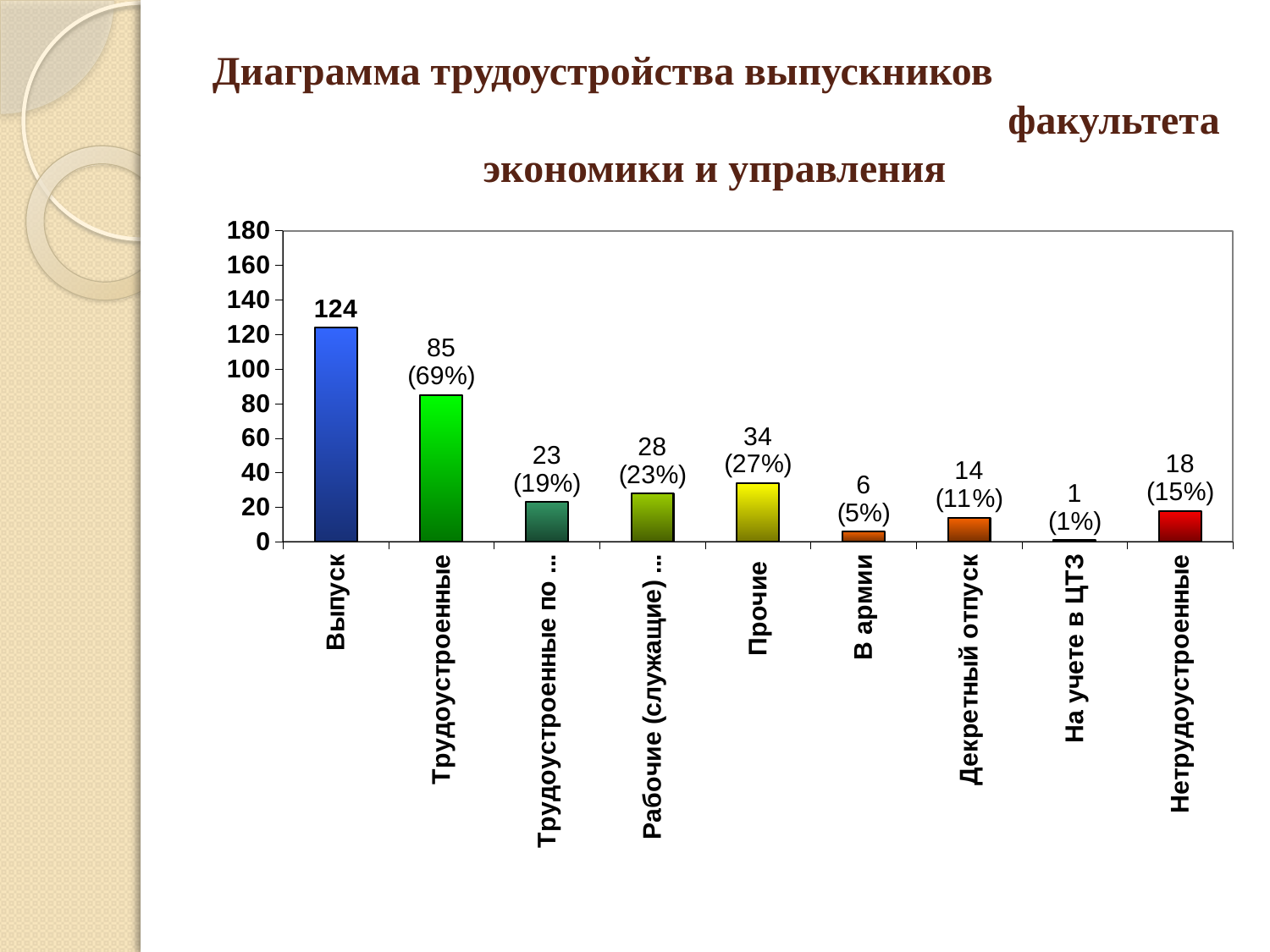
What kind of chart is shown on the slide? bar chart What percentage is shown for Нетрудоустроенные? 15% Which category has the lowest value? На учете в ЦТЗ What is the difference between the values for Выпуск and Трудоустроенные? 39 Which category has the highest value? Выпуск What is the value for Декретный отпуск? 14 What is the value for Выпуск? 124 Is the value for Трудоустроенные greater or less than 80? greater What is the value for На учете в ЦТЗ? 1 How many categories are shown on the x axis? 9 Which is larger, the value for Прочие or the value for В армии? Прочие What is the value for Трудоустроенные? 85